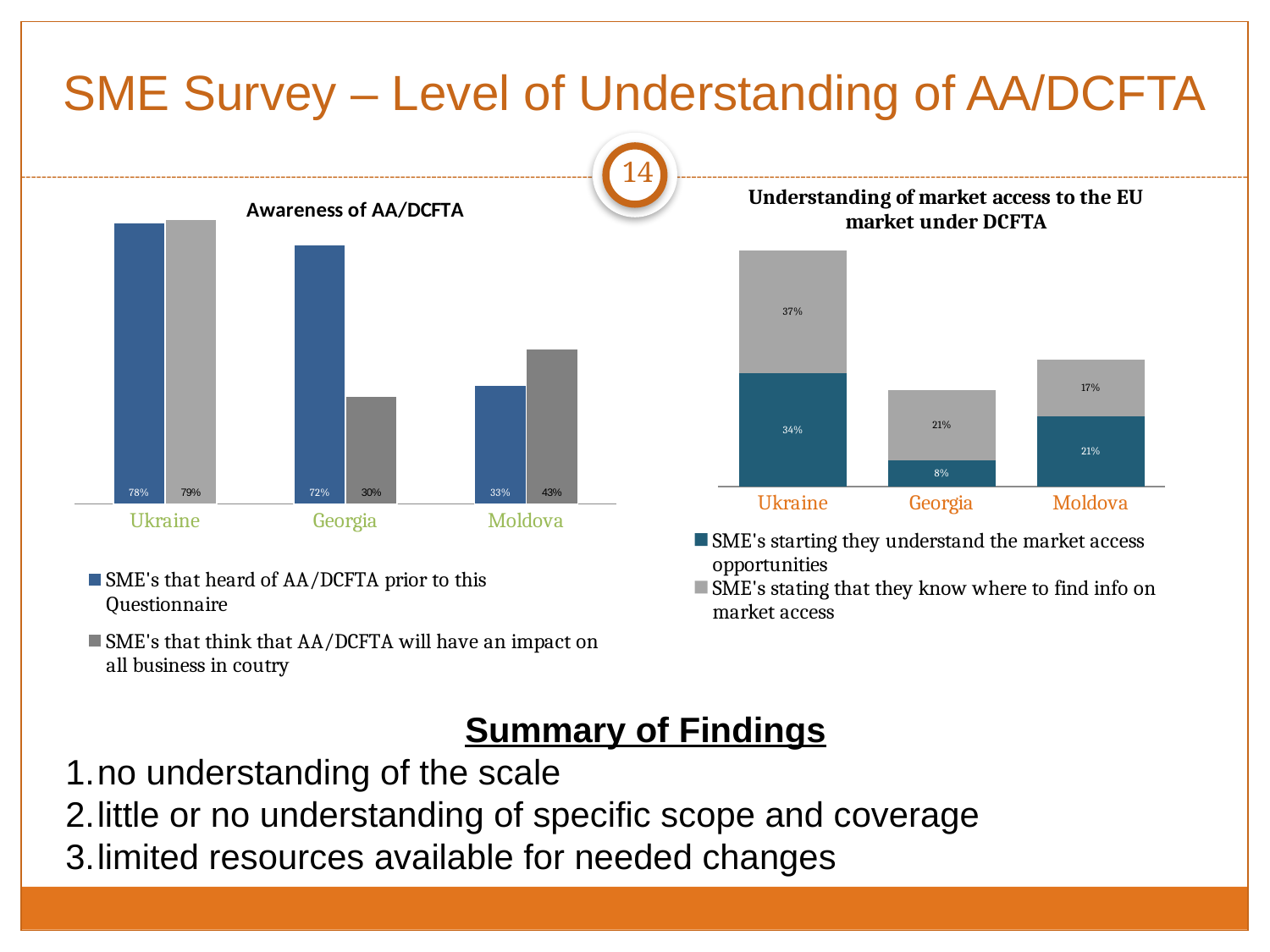
In the 'Awareness of AA/DCFTA' chart, what percentage of SMEs in Georgia had heard of AA/DCFTA prior to the questionnaire? 72% What type of chart is the 'Understanding of market access to the EU market under DCFTA' chart? Stacked bar chart How many series does the legend of the 'Awareness of AA/DCFTA' chart list? 2 In the 'Awareness of AA/DCFTA' chart, what percentage of SMEs in Moldova think that AA/DCFTA will have an impact on all business in the country? 43% In the 'Awareness of AA/DCFTA' chart, what is the difference between the share of SMEs in Georgia that heard of AA/DCFTA and the share that think it will have an impact on all business? 42% In the 'Understanding of market access to the EU market under DCFTA' chart, what percentage of SMEs in Georgia state they understand the market access opportunities? 8% In the 'Understanding of market access to the EU market under DCFTA' chart, what is the total of the stacked bar for Moldova? 38% In the 'Understanding of market access to the EU market under DCFTA' chart, which country has the highest share of SMEs stating they understand the market access opportunities? Ukraine In the 'Awareness of AA/DCFTA' chart, which country has the lowest share of SMEs that heard of AA/DCFTA prior to the questionnaire? Moldova In the 'Understanding of market access to the EU market under DCFTA' chart, what percentage of SMEs in Ukraine state they know where to find info on market access? 37% In the 'Awareness of AA/DCFTA' chart, which is larger for Ukraine: the share that heard of AA/DCFTA or the share that think it will have an impact on all business? The share that think it will have an impact (79%) How many countries are shown on the x axis of the 'Awareness of AA/DCFTA' chart? 3